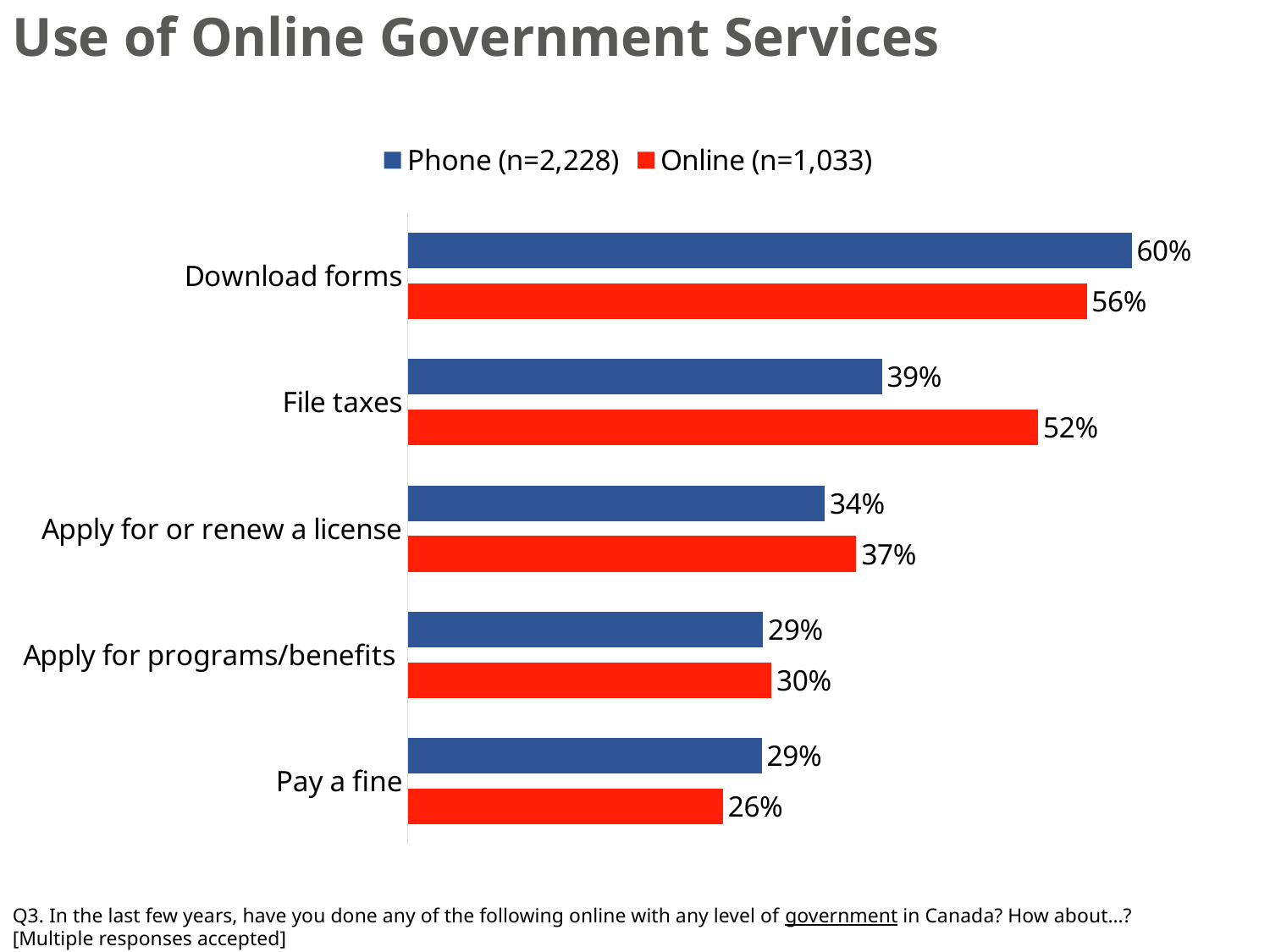
What is the difference between the Online and Phone values for File taxes? 13% What is the Online value for Pay a fine? 26% What is the Phone value for Download forms? 60% Which category has the highest Phone value? Download forms What is the title of the chart? Use of Online Government Services Which category has the lowest Online value? Pay a fine What is the Online value for File taxes? 52% How many categories are shown on the chart? 5 How many series does the legend list? 2 Which is larger for Apply for or renew a license, the Phone value or the Online value? Online What kind of chart is shown on the slide? Bar chart What is the difference between the Phone and Online values for Download forms? 4%